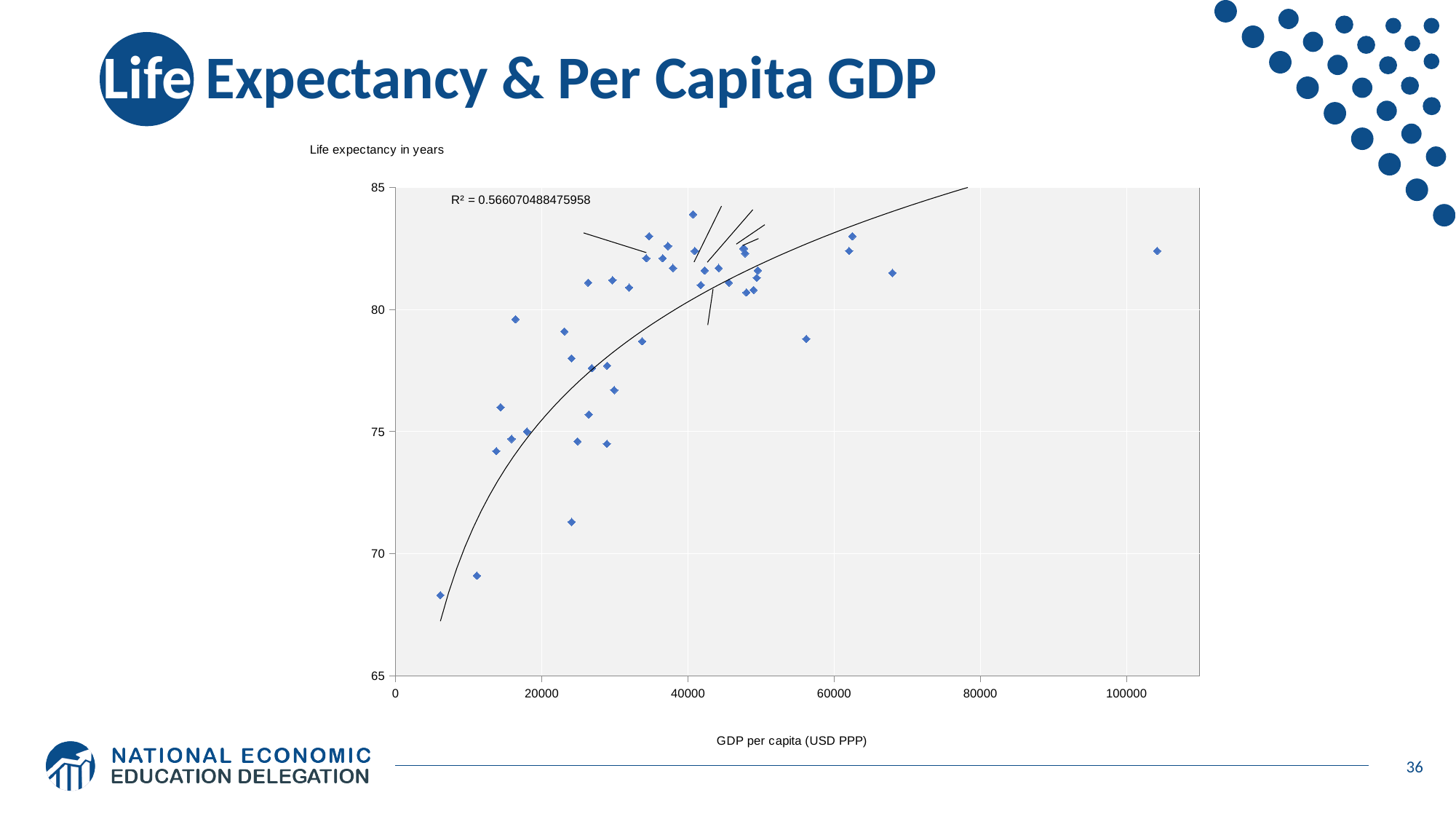
What kind of chart is shown on the slide? Scatter chart Is the life expectancy of the point with the highest GDP per capita greater or less than 80? greater Is the highest GDP per capita plotted greater or less than 100000? greater What is the label of the horizontal axis? GDP per capita (USD PPP) Is the lowest life expectancy plotted greater or less than 70? less Which has the higher life expectancy: the point with GDP per capita just above 100000 or the point with GDP per capita near 56000? The point just above 100000 According to the fitted curve, does life expectancy rise or fall as GDP per capita increases? Rise What R² value is printed on the chart? R² = 0.566070488475958 What is the label of the vertical axis? Life expectancy in years